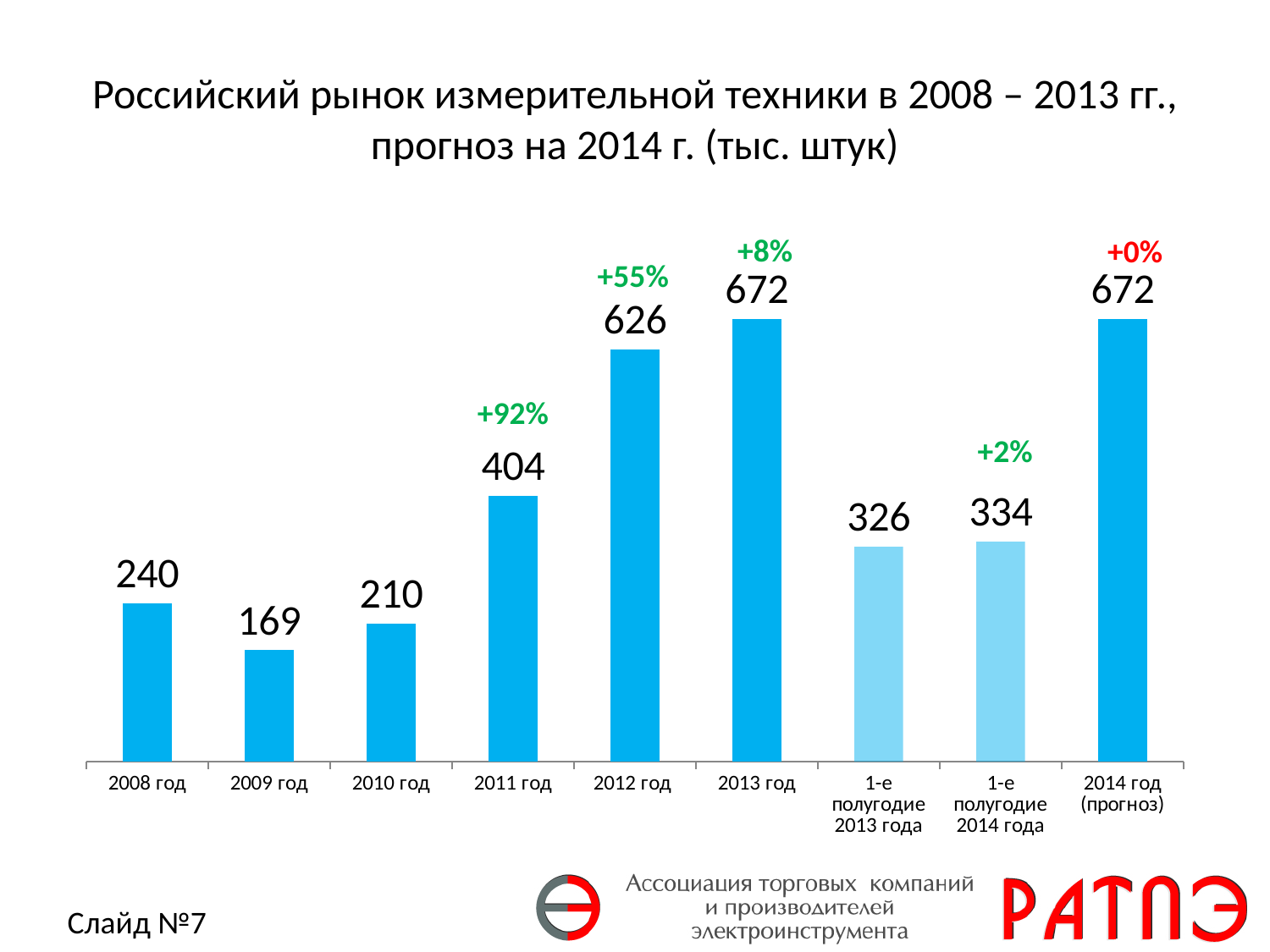
What is the difference between the values for 1-е полугодие 2014 года and 1-е полугодие 2013 года? 8 Do the values rise or fall from 2009 год to 2013 год? rise What is the difference between the values for 2012 год and 2011 год? 222 What percentage change is labelled above the bar for 2012 год? +55% What is the forecast value for 2014 год (прогноз)? 672 How many categories are shown on the x axis? 9 Which category has the lowest value? 2009 год What kind of chart is shown on the slide? bar chart What percentage change is labelled above the bar for 2014 год (прогноз)? +0% Which is larger, the value for 2008 год or the value for 2010 год? 2008 год What is the value for 2011 год? 404 What is the value for 1-е полугодие 2014 года? 334